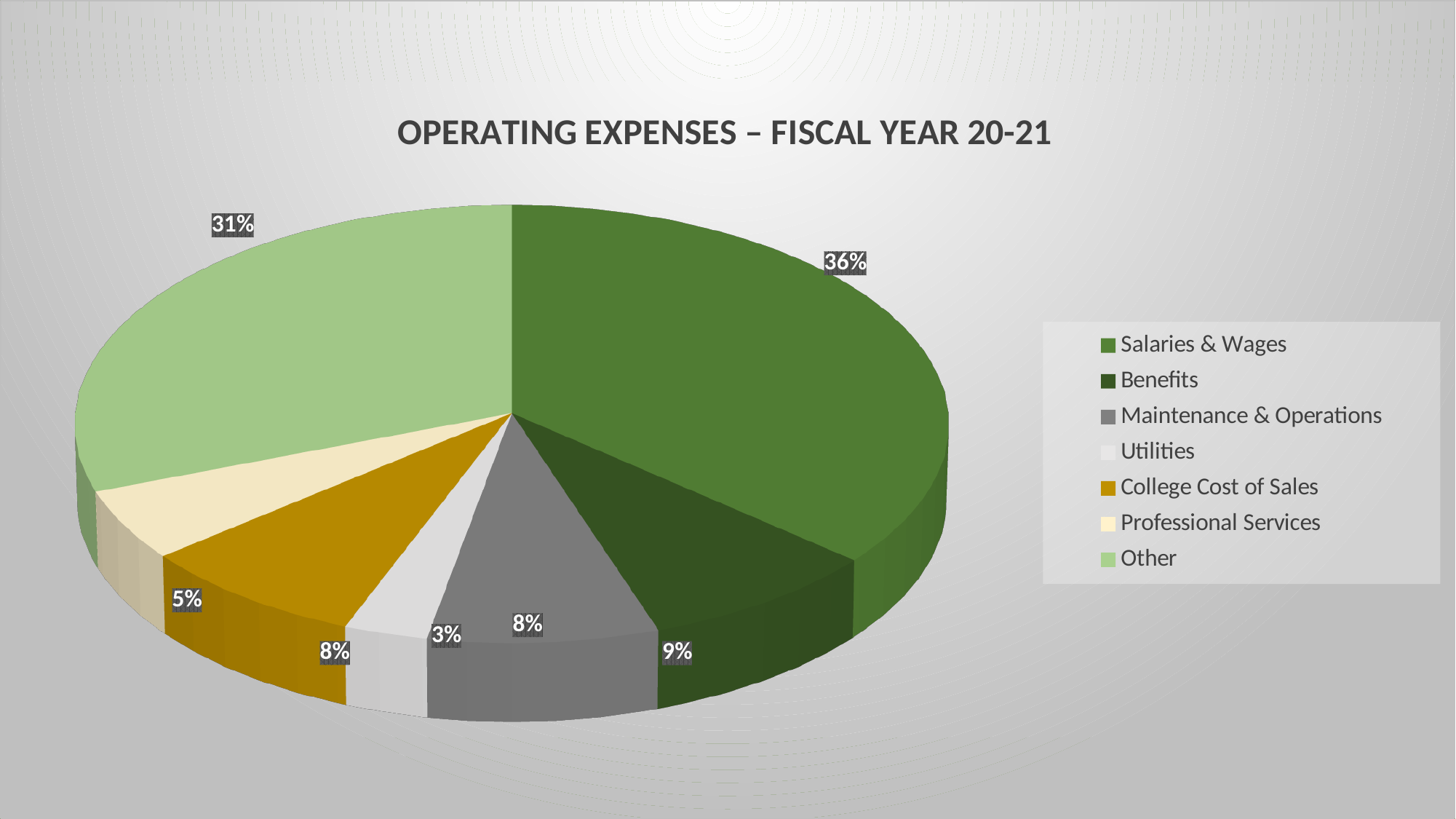
What is the difference in percentage points between Salaries & Wages and Other? 5% What share of operating expenses is Benefits? 9% Which is larger, the share for Benefits or the share for Professional Services? Benefits What share of operating expenses is Professional Services? 5% What share of operating expenses is Other? 31% Which category has the largest share of operating expenses? Salaries & Wages What is the title of the chart? OPERATING EXPENSES – FISCAL YEAR 20-21 How many categories does the legend list? 7 What kind of chart is shown on the slide? Pie chart Which category has the smallest share of operating expenses? Utilities